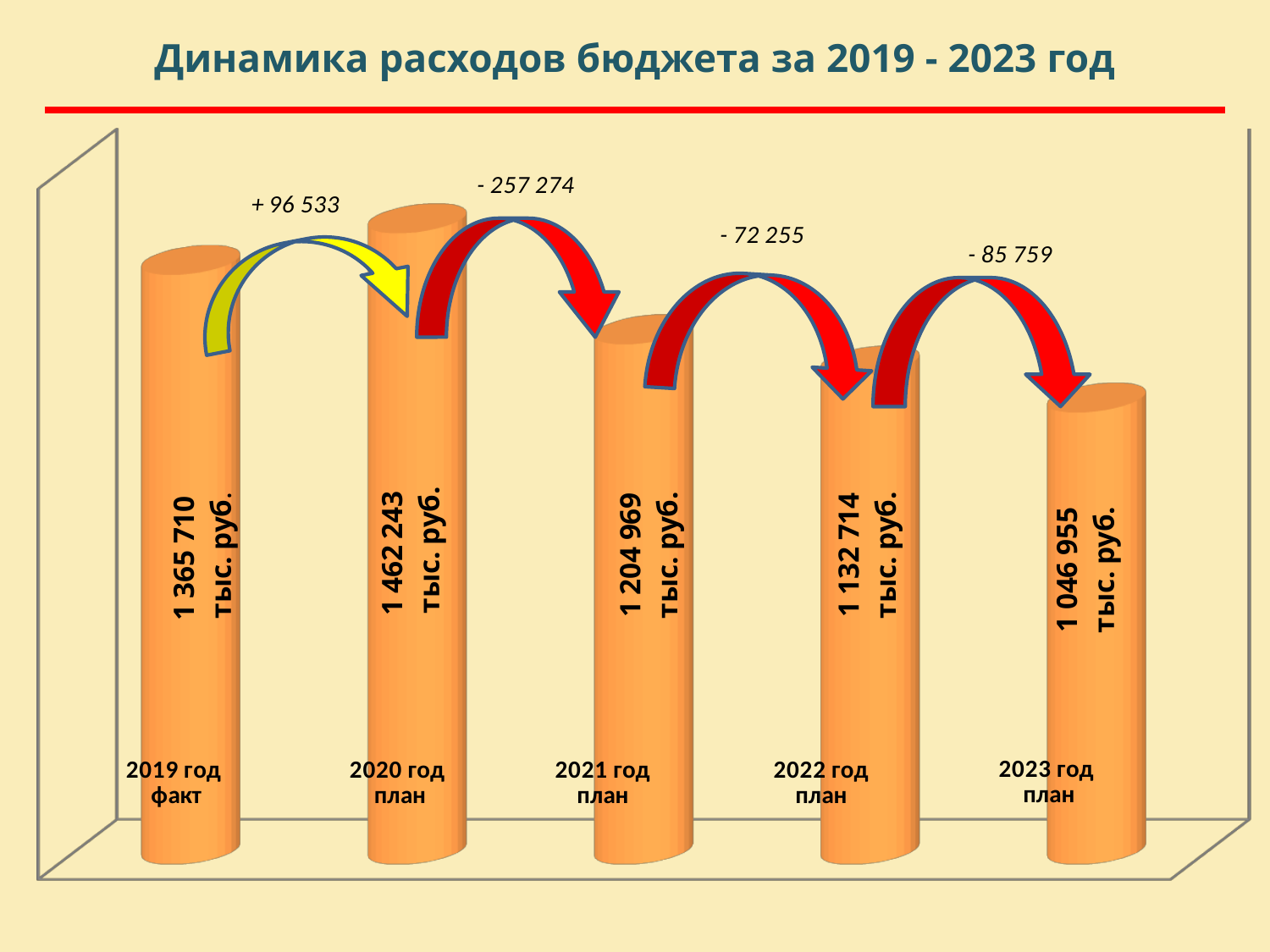
How many years (bars) are shown in the chart? 5 By how much does the 2019 год факт value exceed the 2023 год план value? 318 755 What is the budget expenditure value shown for 2023 год план? 1 046 955 тыс. руб. What is the change in expenditure from 2020 год план to 2021 год план, as labelled on the arrow? - 257 274 What is the budget expenditure value shown for 2021 год план? 1 204 969 тыс. руб. What is the title of the chart? Динамика расходов бюджета за 2019 - 2023 год Which year has the lowest budget expenditure value? 2023 год план What is the budget expenditure value shown for 2019 год факт? 1 365 710 тыс. руб. Which year has the highest budget expenditure value? 2020 год план Which is larger, the value for 2022 год план or the value for 2021 год план? 2021 год план What kind of chart is shown on the slide? Bar chart Do the values rise or fall from 2020 год план through 2023 год план? Fall